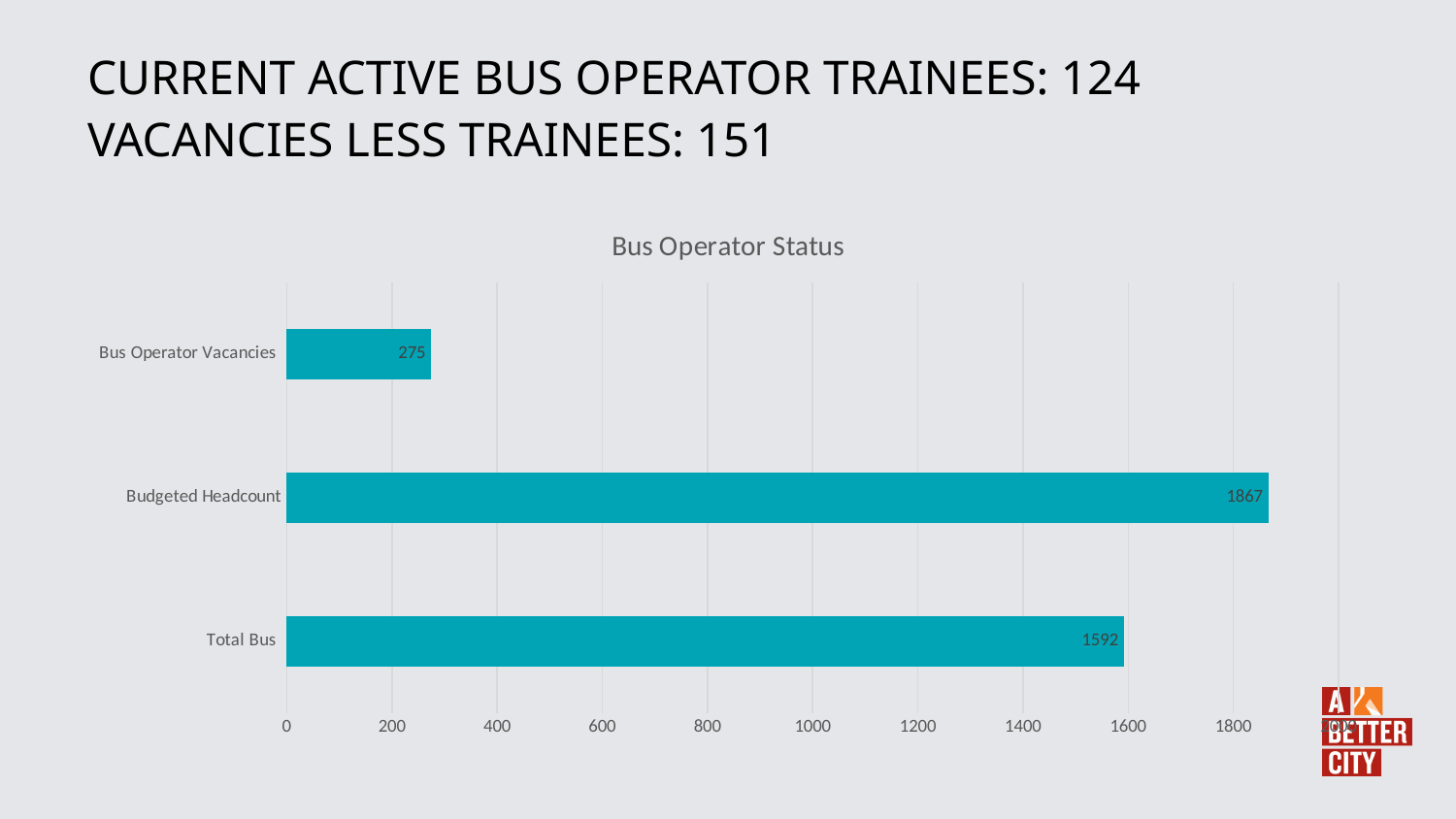
What is the difference between Total Bus and Bus Operator Vacancies? 1317 How many categories are shown in the chart? 3 Which category has the highest value? Budgeted Headcount What is the difference between Budgeted Headcount and Total Bus? 275 What is the value for Bus Operator Vacancies? 275 What is the title of the chart? Bus Operator Status What kind of chart is shown on the slide? bar chart What is the value for Total Bus? 1592 Is the value for Total Bus greater or less than 1400? greater Which category has the lowest value? Bus Operator Vacancies What is the value for Budgeted Headcount? 1867 Which is larger, Total Bus or Budgeted Headcount? Budgeted Headcount